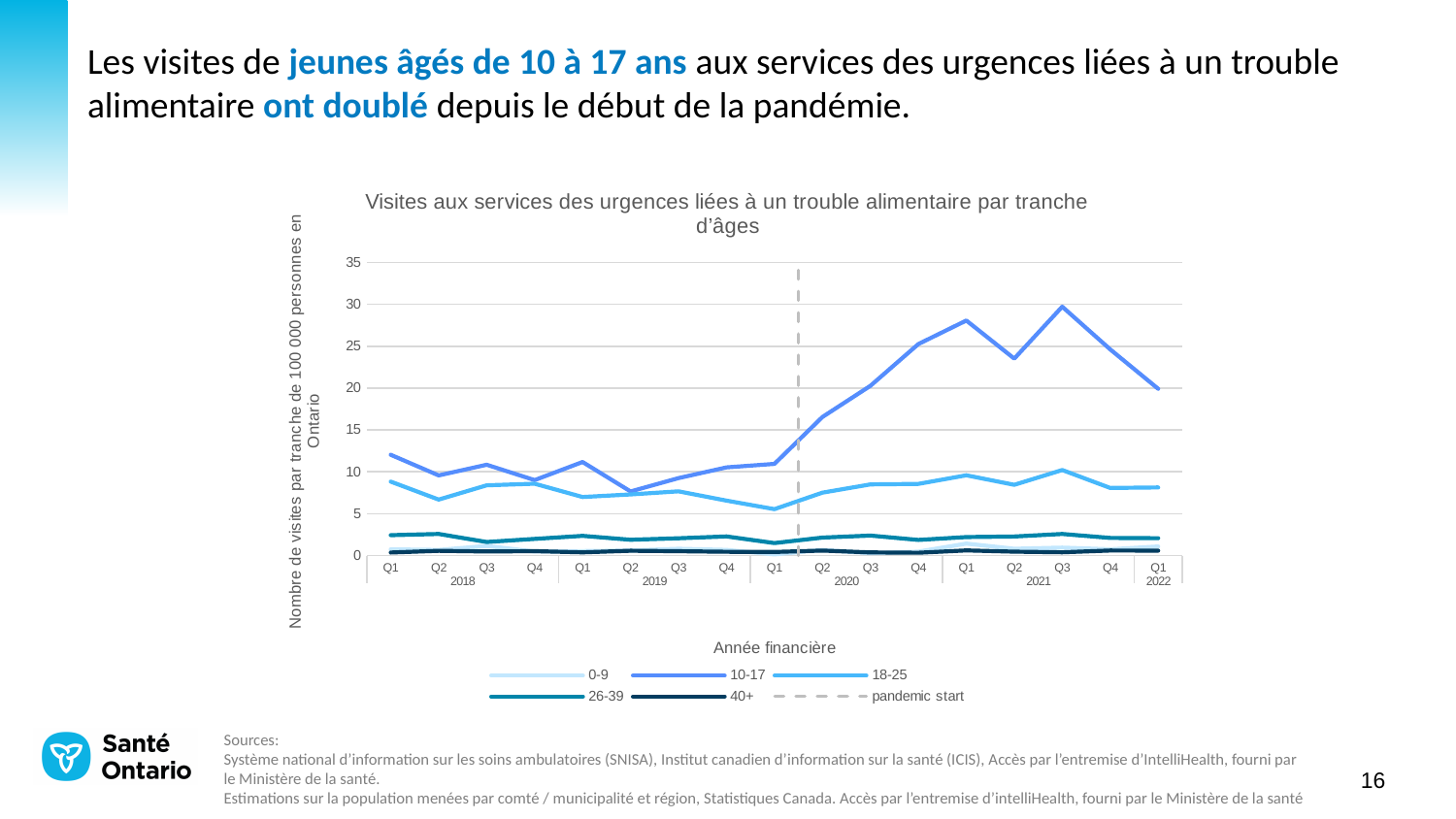
In which quarter does the 10-17 series reach its highest value? Q3 2021 How many quarters are plotted along the x axis of the chart? 17 What does the dashed vertical line in the chart represent? pandemic start How many entries does the chart legend list? 6 What kind of chart is shown on the slide? line chart Is the value for the 10-17 series in Q1 2022 greater or less than 25? less In Q1 2021, which is larger: the value for 10-17 or the value for 18-25? 10-17 Does the 10-17 series rise or fall between Q1 2020 and Q3 2021? rise Is the value for the 10-17 series in Q1 2018 greater or less than 10? greater Which age group has the highest value in Q3 2021? 10-17 Is the value for the 10-17 series in Q3 2021 greater or less than 25? greater